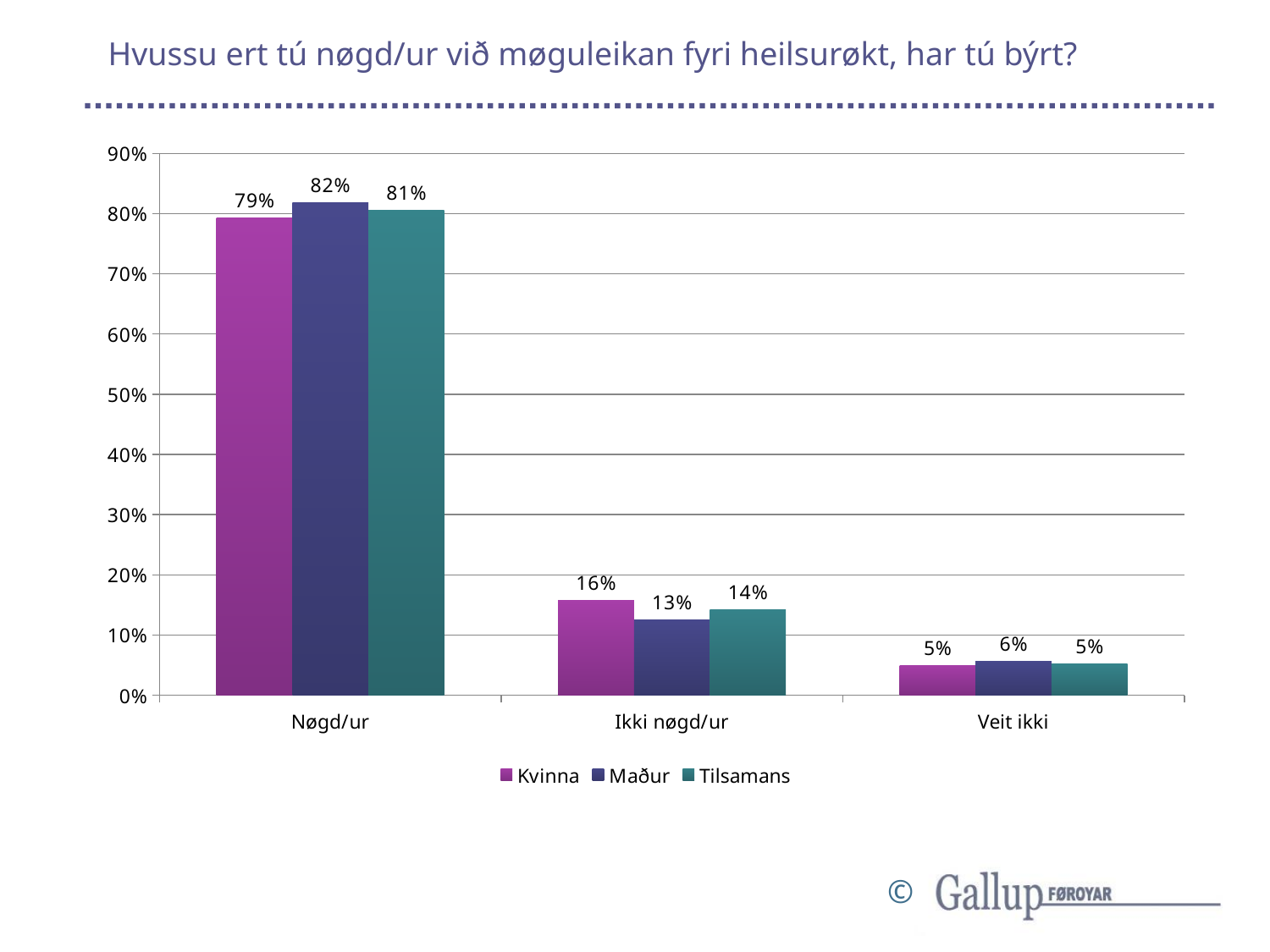
Which category has the lowest value for Kvinna? Veit ikki Is the value for Tilsamans in the Nøgd/ur category greater or less than 70%? greater How many categories are shown on the x axis? 3 What is the value for Maður in the Ikki nøgd/ur category? 13% What are the three series listed in the legend? Kvinna, Maður, Tilsamans What is the value for Tilsamans in the Veit ikki category? 5% How many series does the legend list? 3 What kind of chart is shown on the slide? bar chart What is the difference between the Maður and Kvinna values in the Nøgd/ur category? 3% Which is larger in the Ikki nøgd/ur category, Kvinna or Maður? Kvinna What is the value for Kvinna in the Nøgd/ur category? 79% Which category has the highest value for Tilsamans? Nøgd/ur